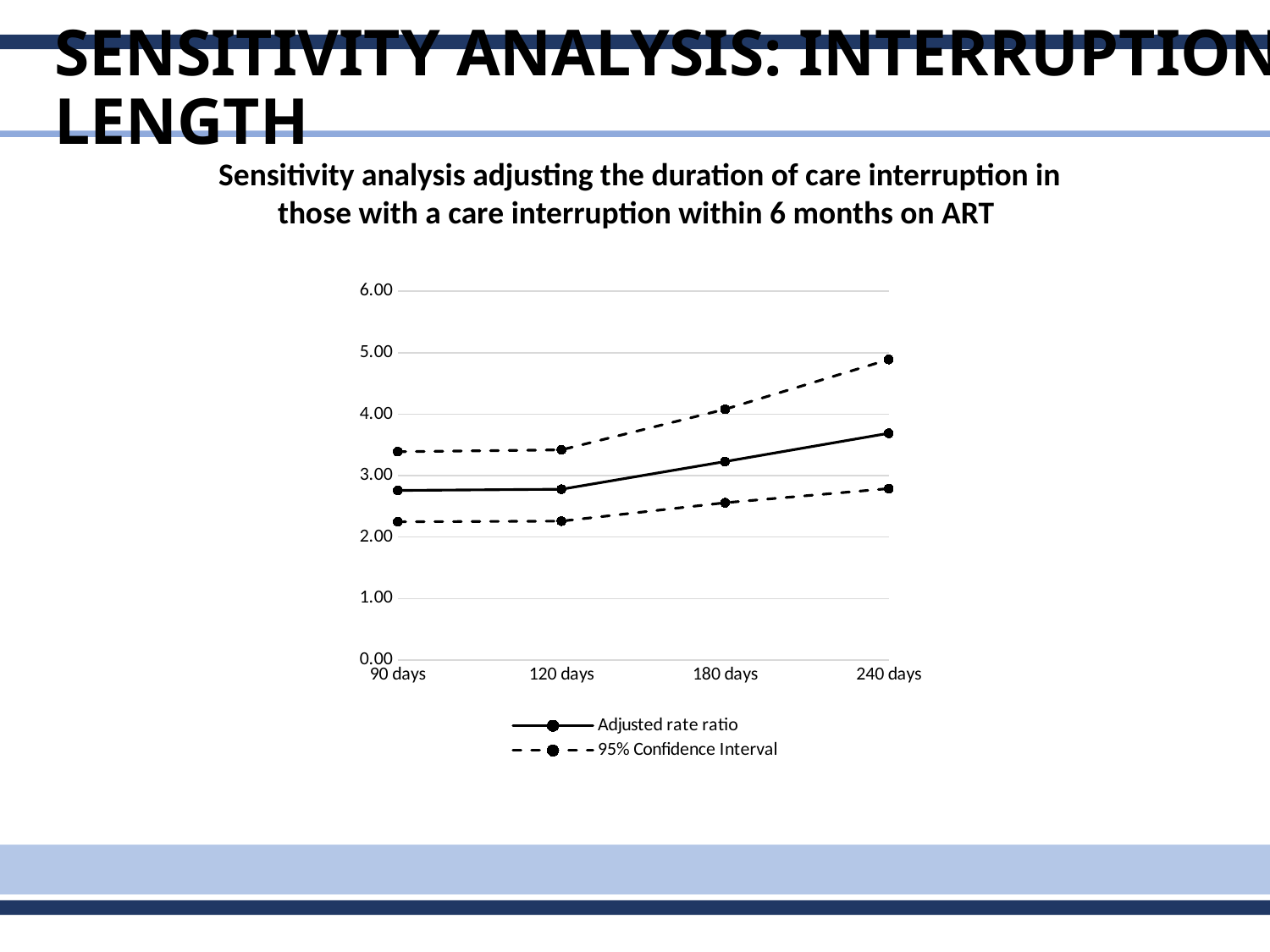
Which is larger, the adjusted rate ratio at 240 days or at 180 days? 240 days How many series does the legend list? 2 What kind of chart is shown on the slide? Line chart Is the adjusted rate ratio at 240 days greater or less than 3.00? greater How many interruption-length categories are shown on the x axis? 4 Is the lower 95% confidence interval value at 90 days greater or less than 3.00? less Does the adjusted rate ratio rise or fall as the interruption length increases from 90 days to 240 days? Rise At which interruption length is the upper 95% confidence interval line highest? 240 days Is the upper 95% confidence interval value at 240 days greater or less than 4.00? greater At which interruption length is the adjusted rate ratio highest? 240 days Which legend entry is drawn with a dashed line? 95% Confidence Interval